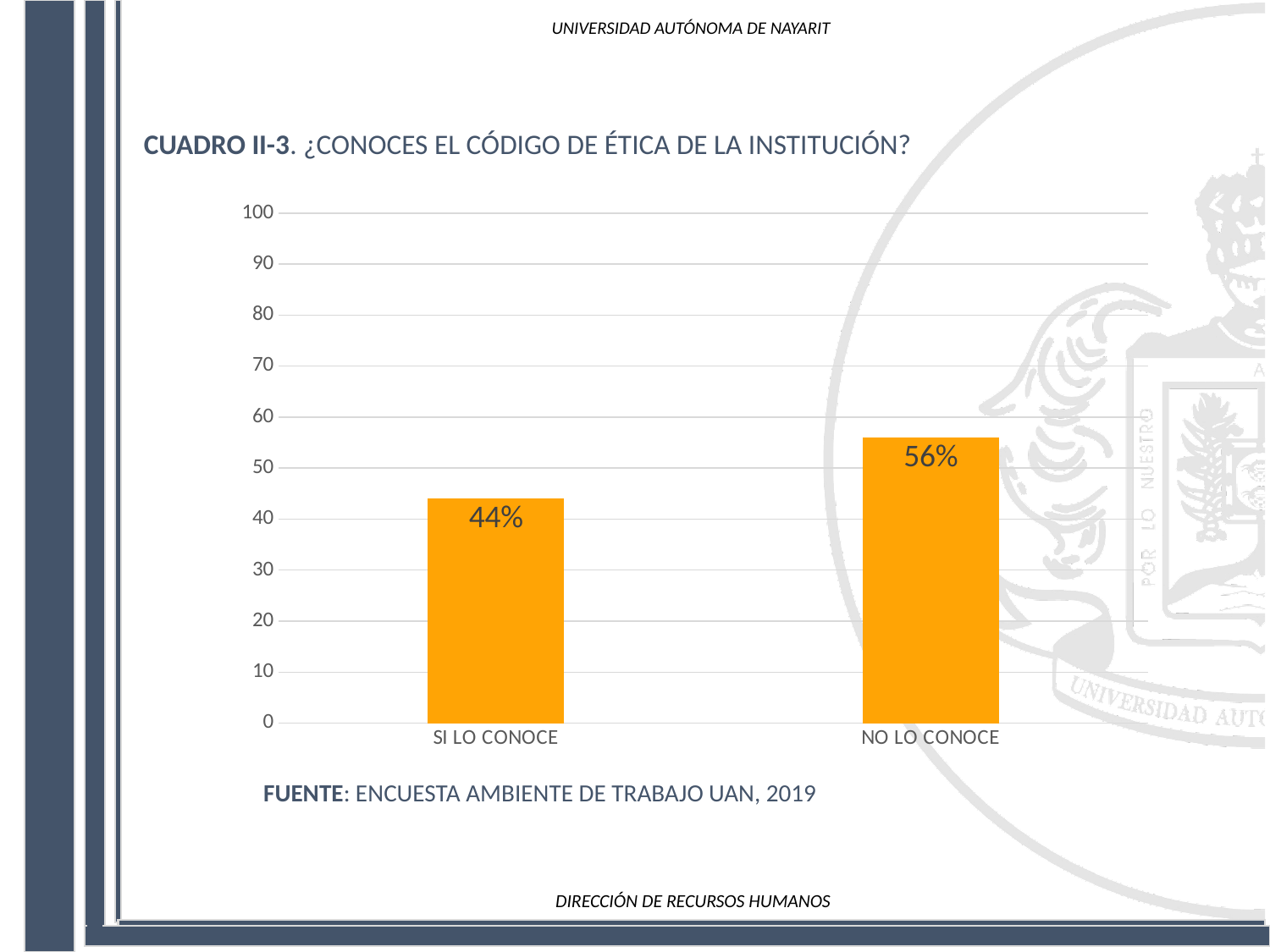
What is the value for NO LO CONOCE? 56% What kind of chart is shown on the slide? bar chart What is the difference between the values for NO LO CONOCE and SI LO CONOCE? 12% What is the value for SI LO CONOCE? 44% Which category has the highest value? NO LO CONOCE How many categories are shown on the x axis? 2 Is the value for NO LO CONOCE greater or less than 50? greater Which category has the lowest value? SI LO CONOCE What source is cited below the chart? ENCUESTA AMBIENTE DE TRABAJO UAN, 2019 Which is larger, the value for SI LO CONOCE or the value for NO LO CONOCE? NO LO CONOCE Is the value for SI LO CONOCE greater or less than 50? less What is the maximum value shown on the y axis? 100